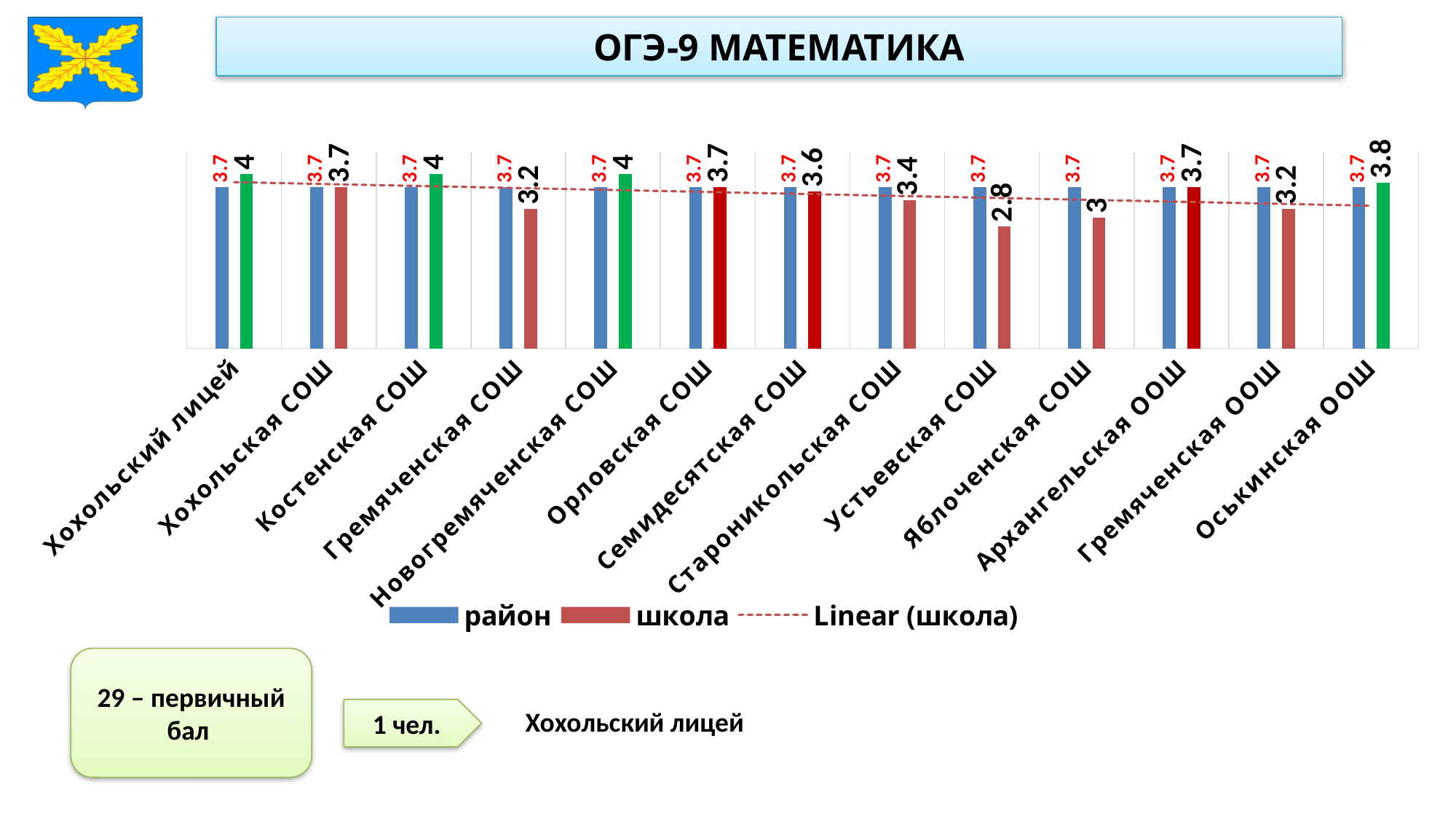
What is the район value for Орловская СОШ? 3.7 What is the школа value for Староникольская СОШ? 3.4 What type of chart is shown on the slide? bar chart How many schools are shown on the x axis? 13 What is the школа value for Устьевская СОШ? 2.8 Which school has the lowest школа value? Устьевская СОШ What is the title of the slide? ОГЭ-9 МАТЕМАТИКА How many entries does the legend list? 3 What is the difference between the школа value for Хохольский лицей and the школа value for Гремяченская СОШ? 0.8 Which is larger: the школа value for Семидесятская СОШ or the школа value for Яблоченская СОШ? Семидесятская СОШ What is the difference between the школа value and the район value for Гремяченская ООШ? 0.5 What is the школа value for Оськинская ООШ? 3.8